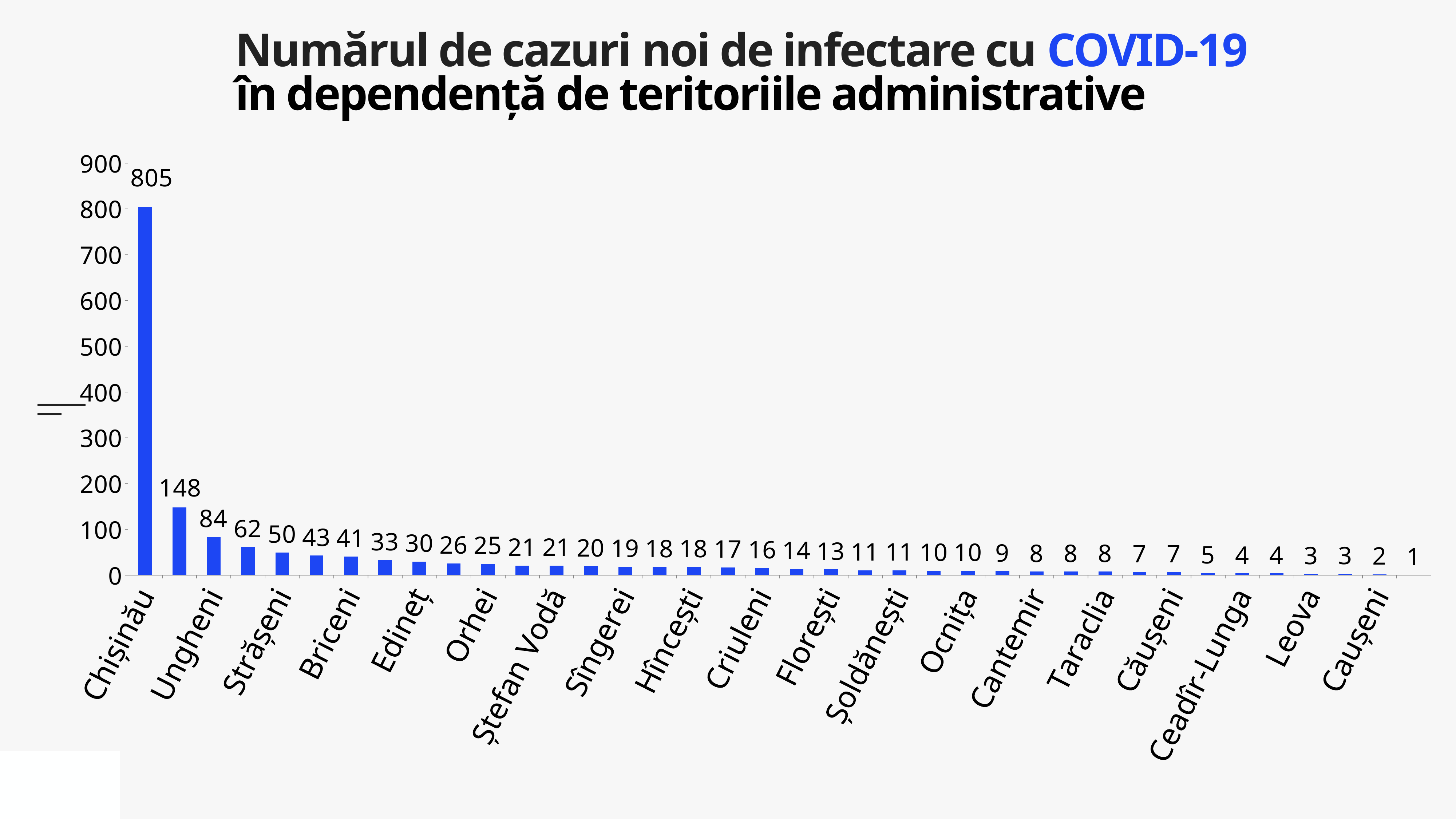
What is the value for Strășeni? 50 Do the values rise or fall from left to right along the x axis? fall What is the value for Chișinău? 805 Is the value for Chișinău greater or less than 800? greater What kind of chart is shown on the slide? bar chart What is the highest tick value shown on the vertical axis? 900 Which is larger, the value for Briceni or the value for Orhei? Briceni How many bars are plotted in the chart? 38 Is the value for Edineț greater or less than 100? less Which territory has the highest number of new cases? Chișinău What is the value for Ungheni? 84 What is the difference between the values for Chișinău and Ungheni? 721